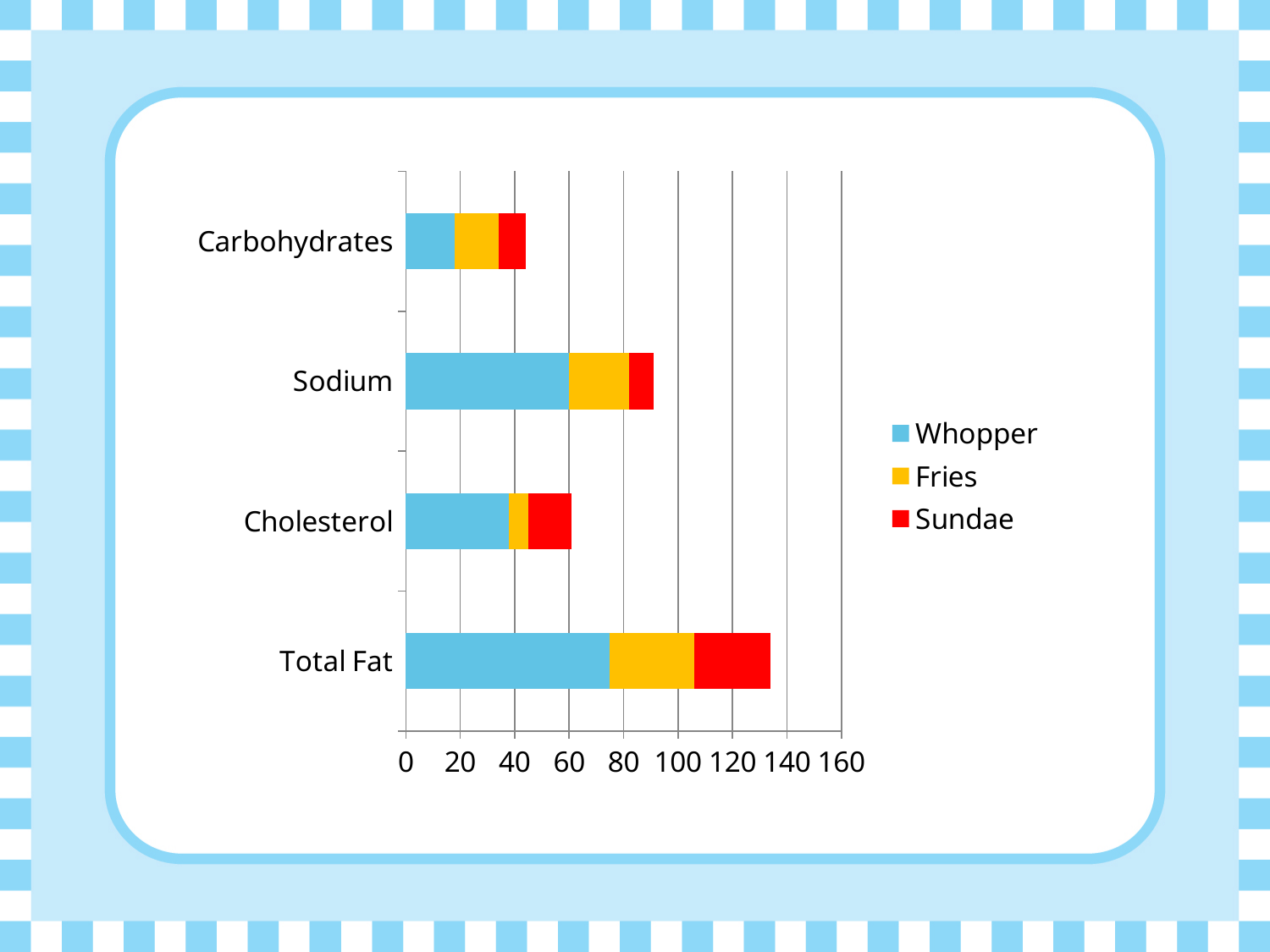
Which category has the shortest total stacked bar? Carbohydrates How many categories are shown on the vertical axis of the chart? 4 What kind of chart is shown on the slide? stacked bar chart Which series is shown in red in the legend? Sundae How many series does the legend list? 3 Which category has the longest total stacked bar? Total Fat Is the total stacked value for Carbohydrates greater or less than 60? less Which has the larger total stacked bar, Sodium or Cholesterol? Sodium Which series is listed first in the legend? Whopper Is the total stacked value for Total Fat greater or less than 120? greater Is the Whopper value for Sodium greater or less than 40? greater